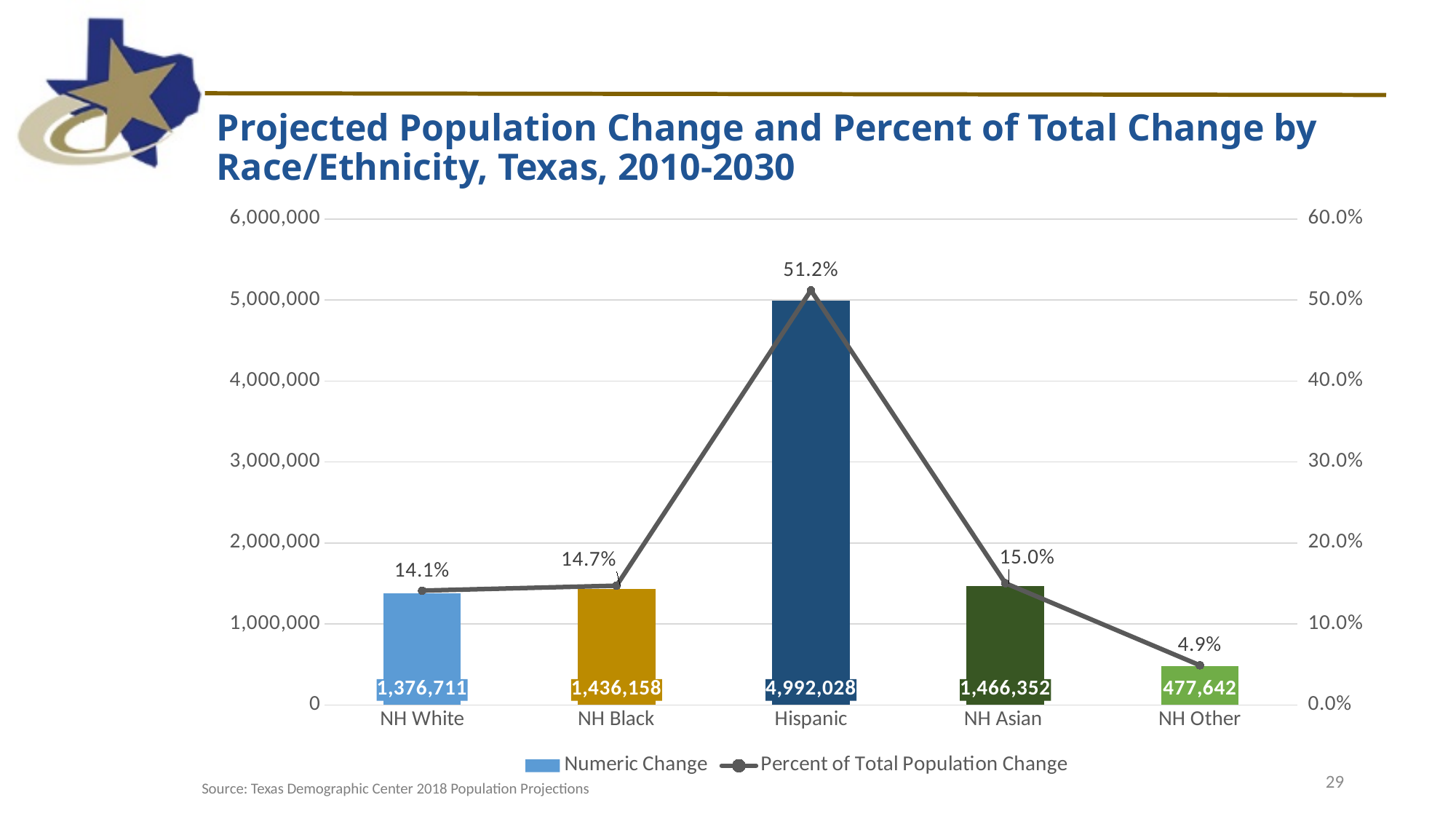
Which race/ethnicity group has the largest projected numeric change? Hispanic How many percentage points higher is the Hispanic share of total change than the NH Black share? 36.5 What percent of total population change is attributed to NH White? 14.1% Which has the larger numeric change, NH Asian or NH Black? NH Asian What percent of total population change is attributed to NH Asian? 15.0% What is the projected numeric change for NH Other? 477,642 How many series does the legend list? 2 Which race/ethnicity group has the smallest percent of total population change? NH Other What kind of chart is shown on the slide? A combination bar and line chart What is the difference in numeric change between Hispanic and NH White? 3,615,317 How many race/ethnicity categories are shown on the x axis? 5 What is the projected numeric change for Hispanic? 4,992,028